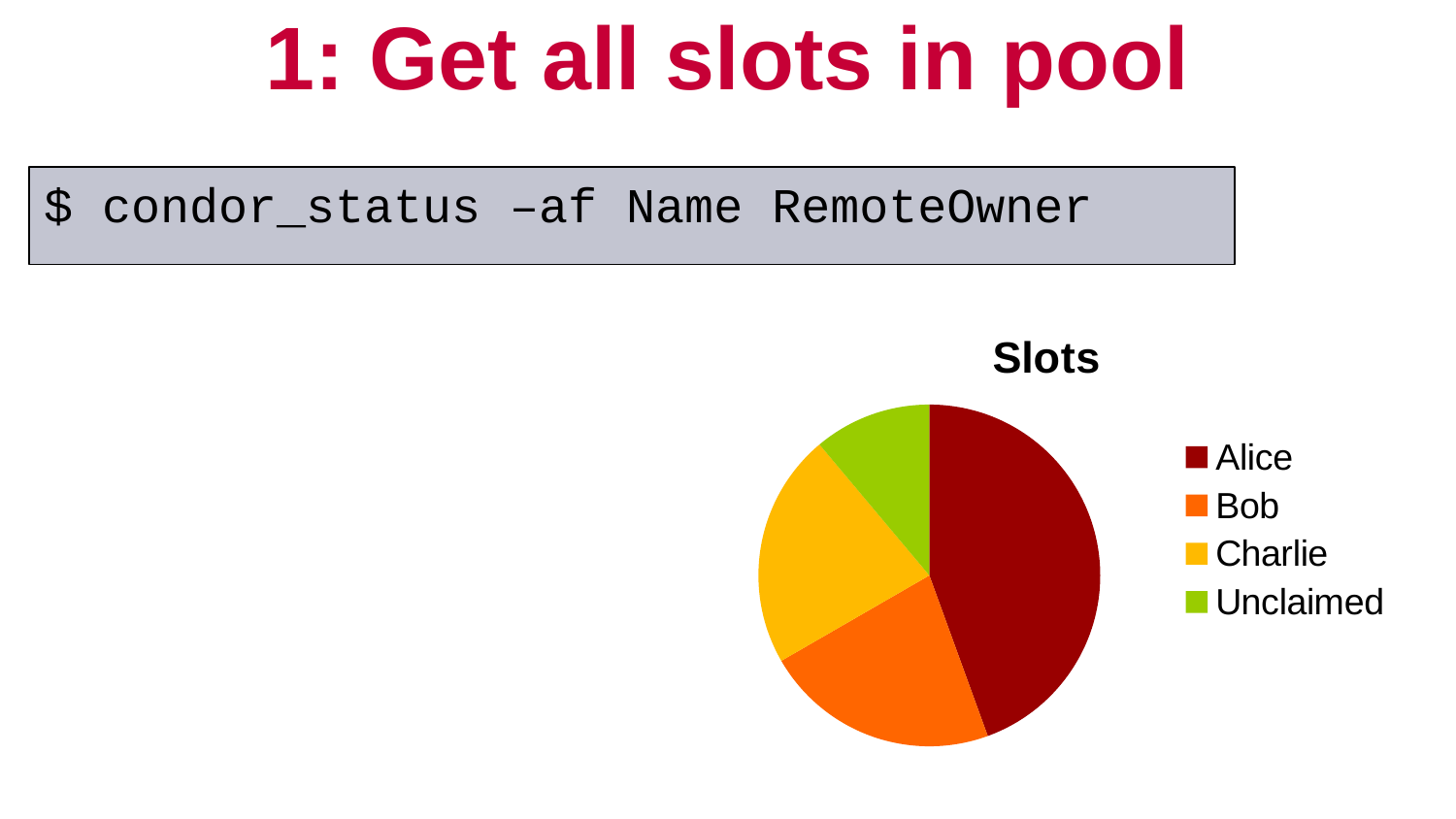
Which slice is larger, Alice or Bob? Alice What is the title of the chart? Slots Which category has the smallest slice of the pie? Unclaimed How many slices does the pie chart have? 4 Which slice is larger, Charlie or Unclaimed? Charlie Which category has the largest slice of the pie? Alice What kind of chart is shown on the slide? pie chart What colour is the slice for Unclaimed? green Which slice is larger, Alice or Unclaimed? Alice How many entries does the legend list? 4